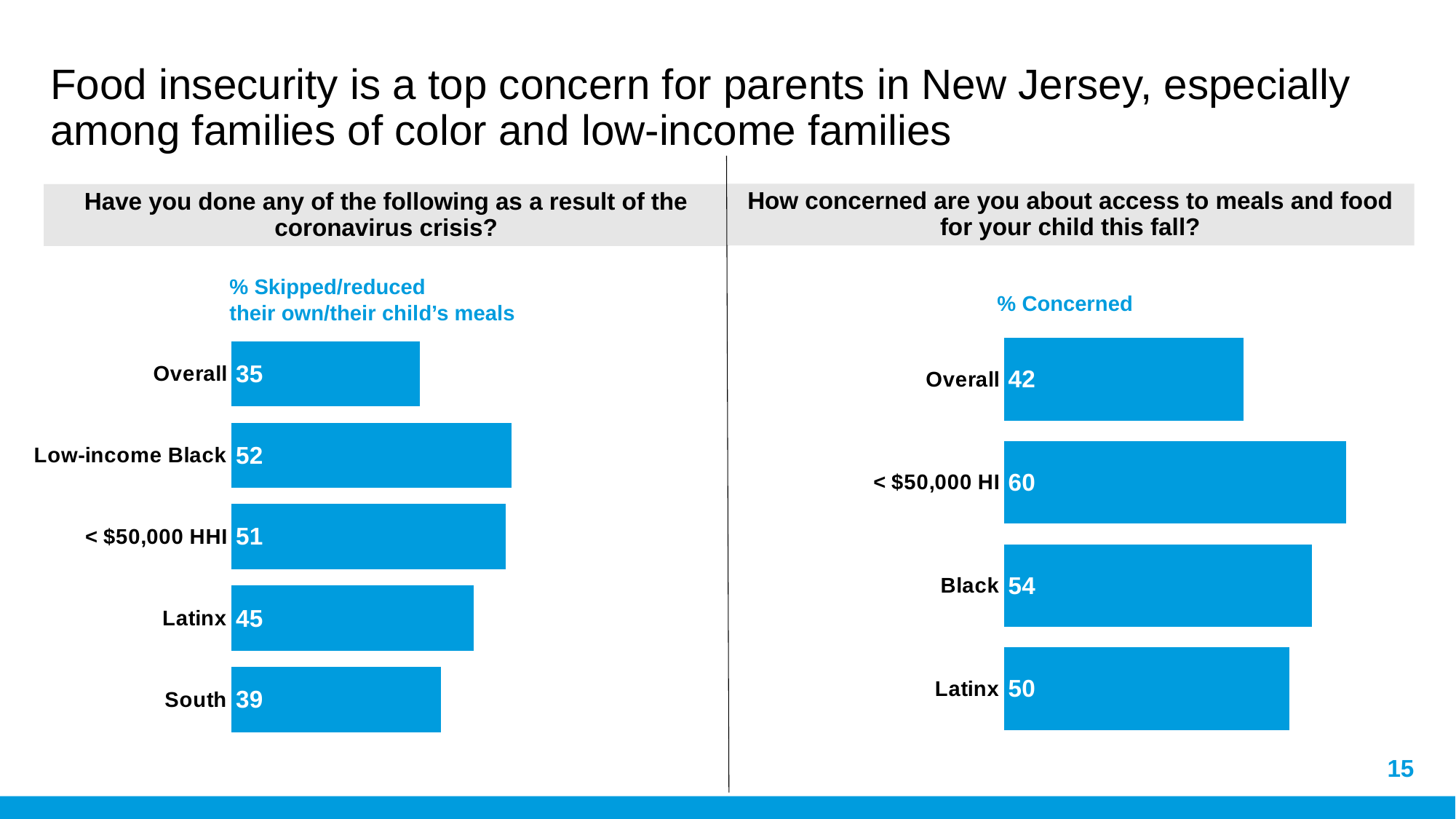
In the right chart (% Concerned), what is the value for < $50,000 HI? 60 In the right chart (% Concerned), which is larger, the value for Black or the value for Latinx? Black What type of chart is the right chart (% Concerned)? Bar chart In the left chart (% Skipped/reduced their own/their child's meals), what is the difference between the Latinx value and the Overall value? 10 In the right chart (% Concerned), what is the value for Black? 54 In the right chart (% Concerned), what is the difference between the < $50,000 HI value and the Overall value? 18 In the right chart (% Concerned), which category has the highest value? < $50,000 HI In the left chart (% Skipped/reduced their own/their child's meals), what is the value for Low-income Black? 52 In the left chart (% Skipped/reduced their own/their child's meals), what is the value for South? 39 In the left chart (% Skipped/reduced their own/their child's meals), which category has the highest value? Low-income Black In the left chart (% Skipped/reduced their own/their child's meals), how many categories are shown? 5 In the left chart (% Skipped/reduced their own/their child's meals), which category has the lowest value? Overall